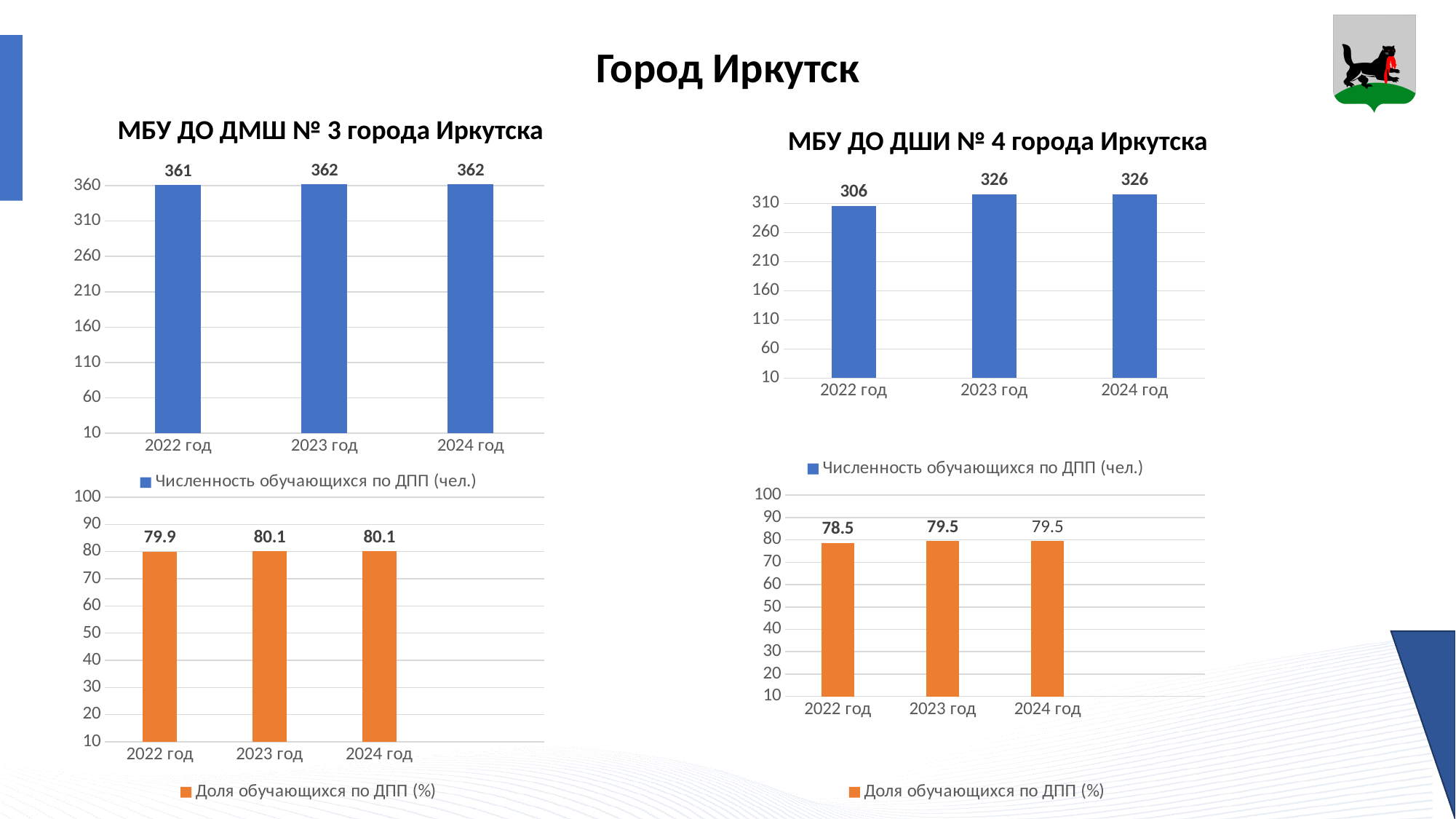
In the top-right chart (МБУ ДО ДШИ № 4 города Иркутска, Численность обучающихся по ДПП), which year has the lowest value? 2022 год In the top-left chart (МБУ ДО ДМШ № 3 города Иркутска, Численность обучающихся по ДПП), how many years are shown on the x axis? 3 In the bottom-left chart (МБУ ДО ДМШ № 3 города Иркутска, Доля обучающихся по ДПП), what is the value for 2022 год? 79.9 In the top-right chart (МБУ ДО ДШИ № 4 города Иркутска, Численность обучающихся по ДПП), what is the difference between the 2023 год and 2022 год values? 20 What kind of chart is the bottom-left chart (МБУ ДО ДМШ № 3 города Иркутска, Доля обучающихся по ДПП)? Bar chart In the top-right chart (МБУ ДО ДШИ № 4 города Иркутска, Численность обучающихся по ДПП), what is the value for 2022 год? 306 What is the legend entry of the bottom-right chart (МБУ ДО ДШИ № 4 города Иркутска)? Доля обучающихся по ДПП (%) In the bottom-right chart (МБУ ДО ДШИ № 4 города Иркутска, Доля обучающихся по ДПП), what is the value for 2023 год? 79.5 In the top-left chart (МБУ ДО ДМШ № 3 города Иркутска, Численность обучающихся по ДПП), what is the value for 2022 год? 361 In the bottom-right chart (МБУ ДО ДШИ № 4 города Иркутска, Доля обучающихся по ДПП), which year has the lowest value? 2022 год In the top-left chart (МБУ ДО ДМШ № 3 города Иркутска, Численность обучающихся по ДПП), is the value for 2023 год larger than the value for 2022 год? Yes In the top-right chart (МБУ ДО ДШИ № 4 города Иркутска, Численность обучающихся по ДПП), do the values rise or fall from 2022 год to 2023 год? Rise